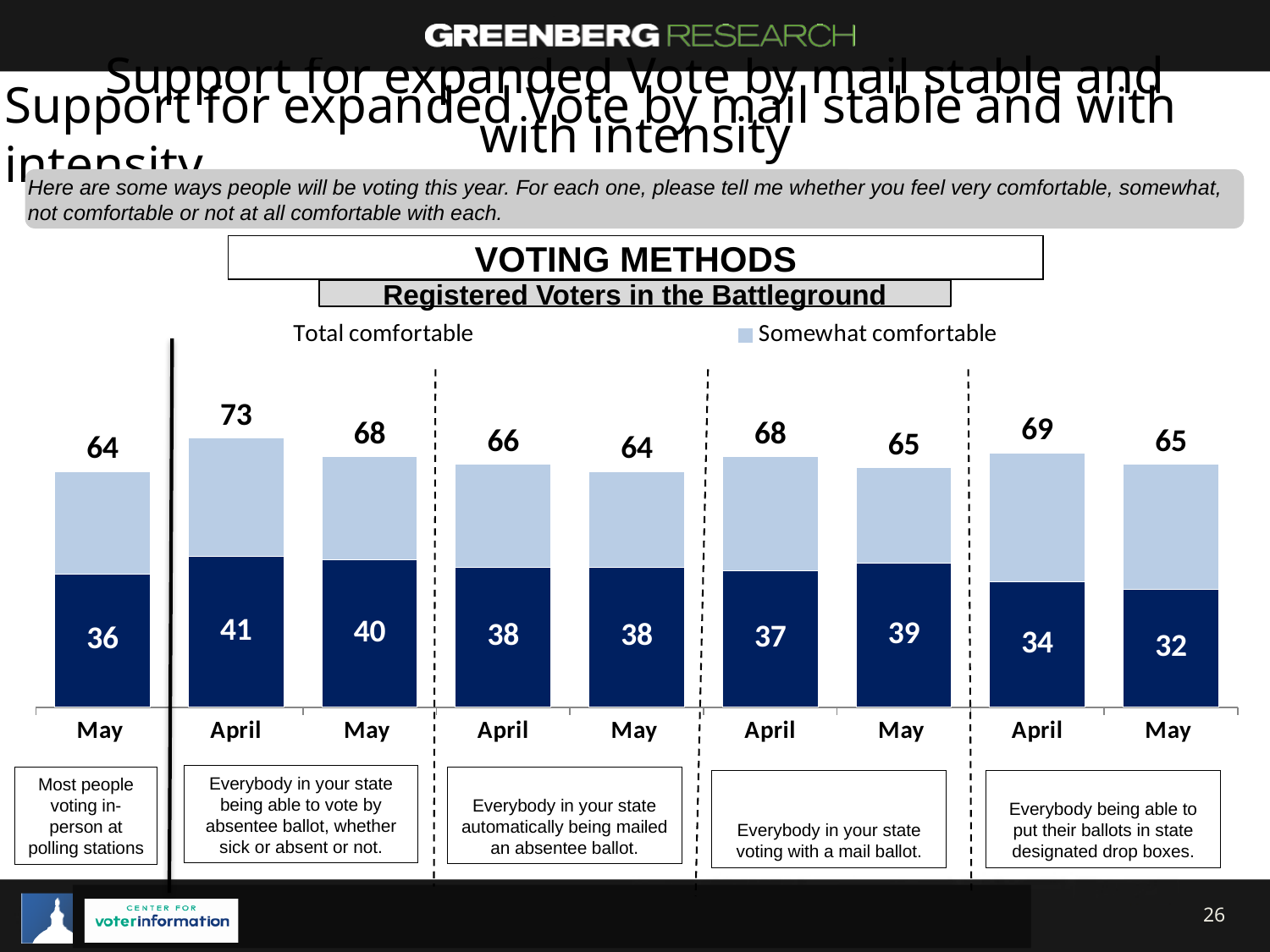
Which is larger: the April total for 'Everybody in your state voting with a mail ballot' or the April total for 'Everybody being able to put their ballots in state designated drop boxes'? Drop boxes (69) How many entries does the legend list? 2 How many bars are plotted in the chart? 9 What is the subtitle shown beneath 'VOTING METHODS' on the chart? Registered Voters in the Battleground Which bar has the highest total comfortable value? April, absentee ballot whether sick or absent or not (73) What is the total comfortable value for the May bar for 'Everybody being able to put their ballots in state designated drop boxes'? 65 What is the total comfortable value for the May bar for 'Most people voting in-person at polling stations'? 64 What is the difference between the April and May total comfortable values for 'Everybody in your state being able to vote by absentee ballot, whether sick or absent or not'? 5 From April to May, does the total comfortable value for 'Everybody in your state automatically being mailed an absentee ballot' rise or fall? Fall Which bar has the lowest value in its dark bottom segment? May, state designated drop boxes (32) What is the value printed inside the dark bottom segment of the April bar for 'Everybody in your state being able to vote by absentee ballot, whether sick or absent or not'? 41 What kind of chart is shown on the slide? Stacked bar chart